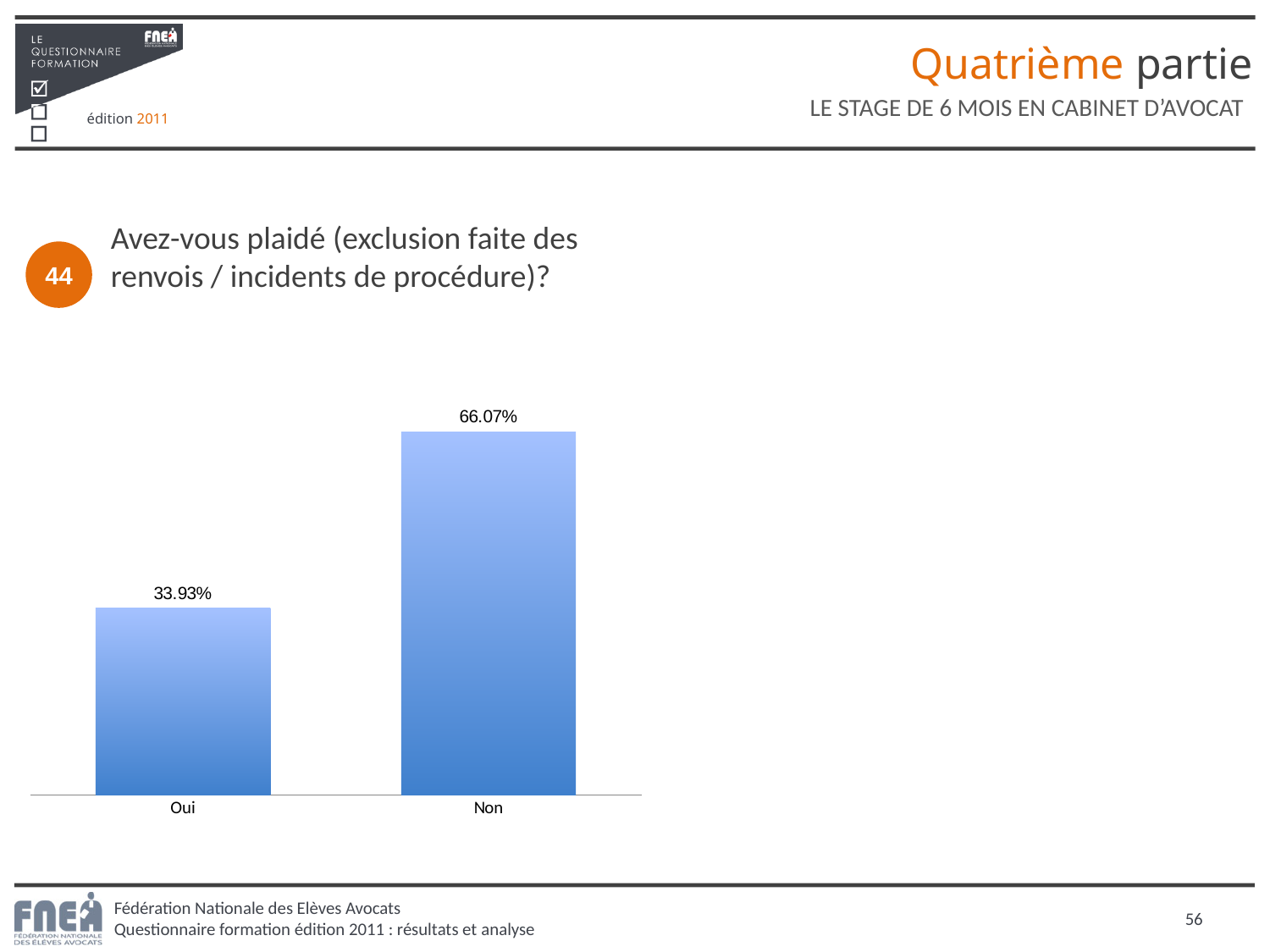
Which is larger, the value for "Oui" or the value for "Non"? Non What is the total of the two values shown in the chart? 100% What question does the chart on the slide answer? Avez-vous plaidé (exclusion faite des renvois / incidents de procédure)? What is the value for "Oui"? 33.93% Which category has the lowest value? Oui Which category has the highest value? Non What is the difference between the values for "Non" and "Oui"? 32.14% What is the value for "Non"? 66.07% What kind of chart is shown on the slide? Bar chart How many categories are shown in the chart? 2 What is the question number shown next to the chart's question? 44